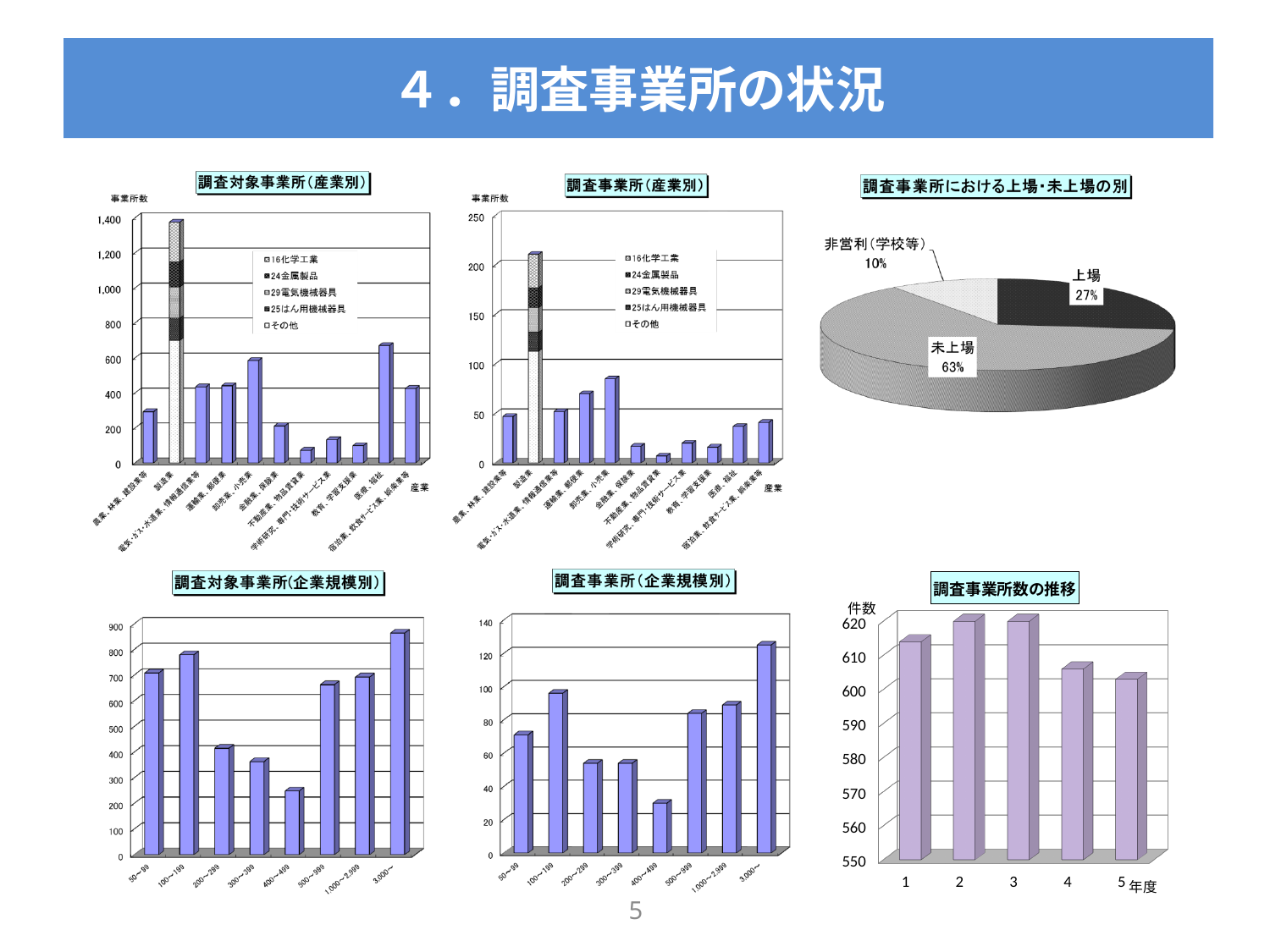
In the chart 調査事業所(企業規模別), which company-size category has the lowest value? 400~499 In the chart 調査対象事業所(企業規模別), which company-size category has the highest value? 3,000~ In the chart 調査事業所数の推移, is the value for year 4 greater or less than 610? less In the pie chart 調査事業所における上場・未上場の別, what share is 上場? 27% In the pie chart 調査事業所における上場・未上場の別, which slice is the smallest? 非営利(学校等) How many company-size categories are shown in the chart 調査事業所(企業規模別)? 8 In the chart 調査対象事業所(産業別), is the value for 製造業 greater or less than 1,200? greater In the chart 調査対象事業所(産業別), which industry has the highest number of establishments? 製造業 In the pie chart 調査事業所における上場・未上場の別, what share is 未上場? 63% In the pie chart 調査事業所における上場・未上場の別, what is the difference between the 未上場 share and the 上場 share? 36% How many entries does the legend list in the chart 調査事業所(産業別)? 5 What kind of chart is 調査事業所における上場・未上場の別? Pie chart